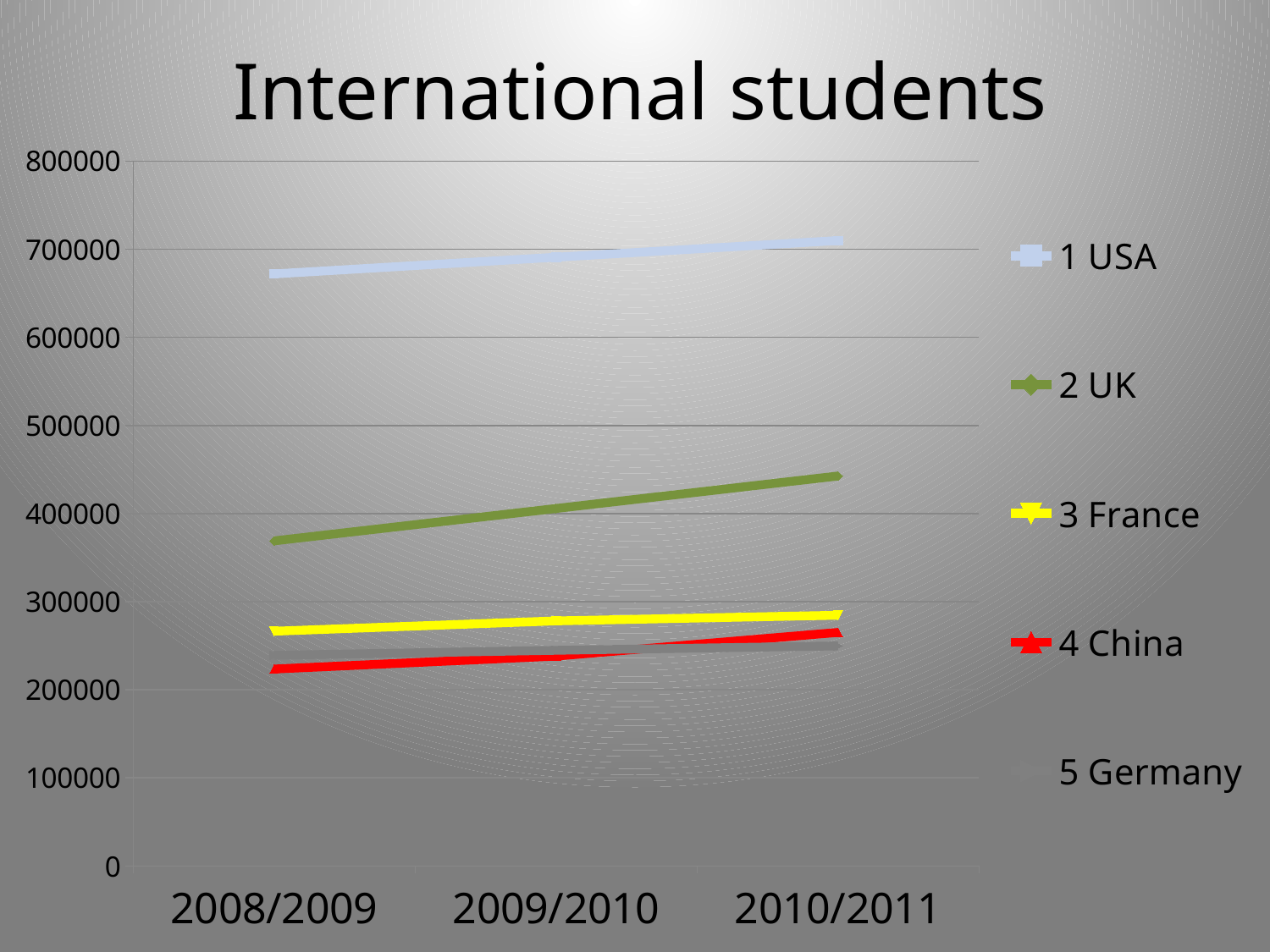
Is the value for 2 UK in 2010/2011 greater or less than 400000? greater Is the value for 1 USA in 2008/2009 greater or less than 700000? less Which country has the highest number of international students across all years? 1 USA What is the title of the chart? International students Is the value for 2 UK in 2008/2009 greater or less than 400000? less How many academic years are shown on the x axis? 3 Which country has the lowest value in 2008/2009? 4 China Does the number of international students for 2 UK rise or fall from 2008/2009 to 2010/2011? rise What kind of chart is shown on the slide? line chart In 2010/2011, which is larger: the value for 2 UK or the value for 3 France? 2 UK How many series does the legend list? 5